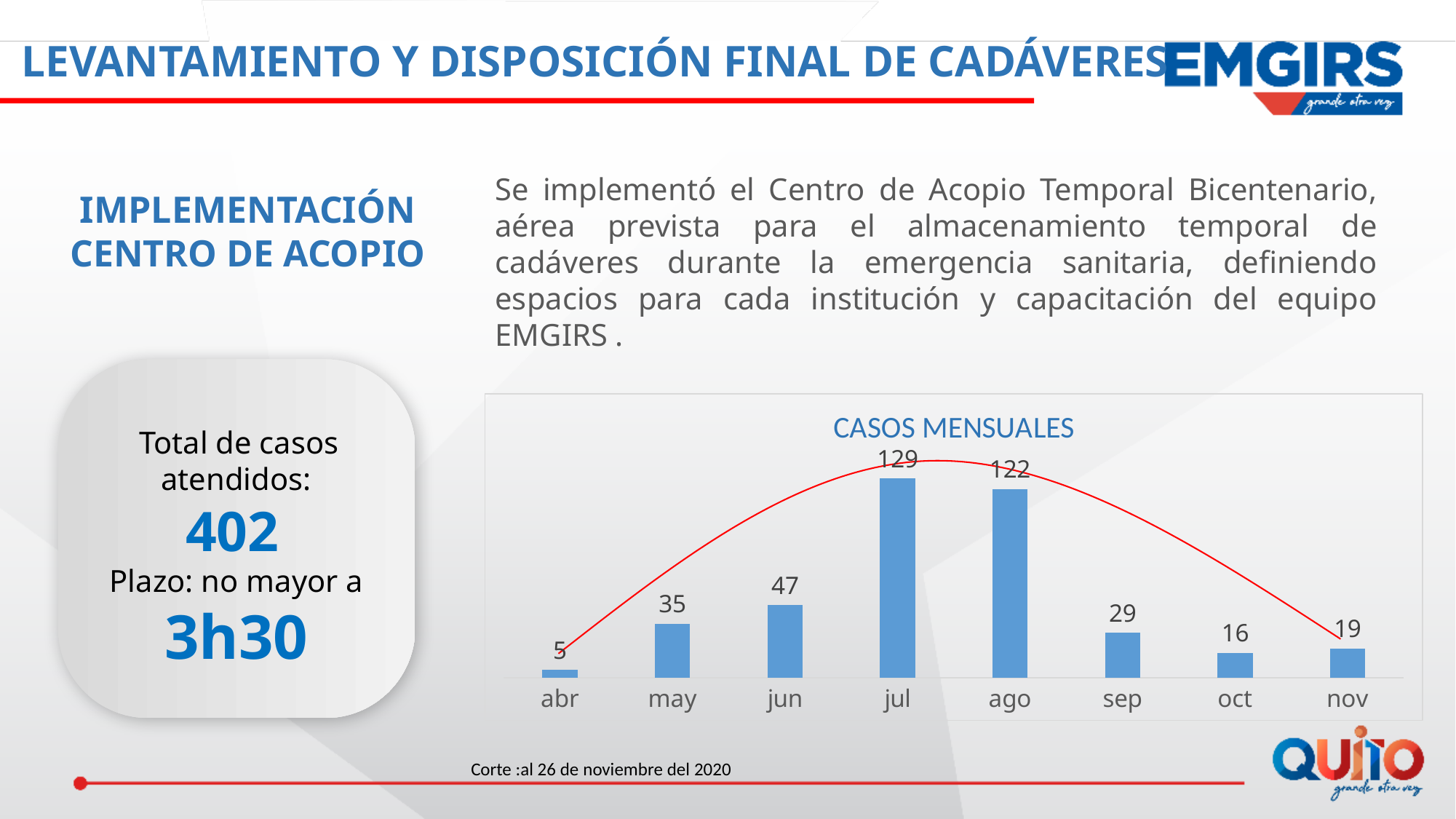
What is the difference between the values for jun and may in the CASOS MENSUALES chart? 12 What is the value for abr in the CASOS MENSUALES chart? 5 What is the title of the chart on the slide? CASOS MENSUALES What is the value for jul in the CASOS MENSUALES chart? 129 What kind of chart is CASOS MENSUALES? bar chart Which is larger in the CASOS MENSUALES chart, the value for sep or the value for oct? sep Which month has the highest value in the CASOS MENSUALES chart? jul What is the value for nov in the CASOS MENSUALES chart? 19 What is the difference between the values for jul and ago in the CASOS MENSUALES chart? 7 In the CASOS MENSUALES chart, do the values rise or fall from abr to jul? rise How many months are shown on the x axis of the CASOS MENSUALES chart? 8 Which month has the lowest value in the CASOS MENSUALES chart? abr